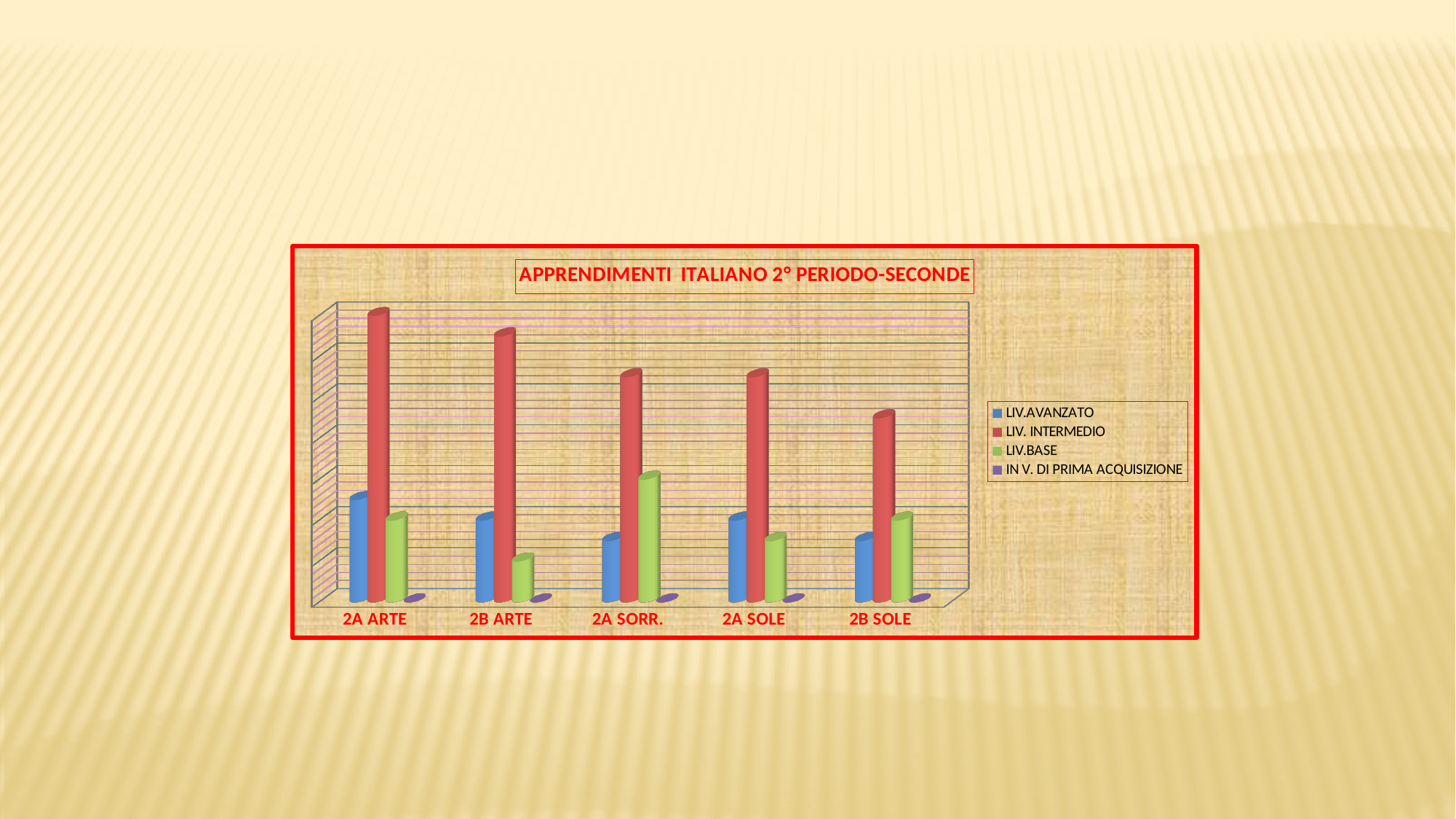
Which class has the highest LIV.BASE bar? 2A SORR. What kind of chart is shown on the slide? Bar chart Which class has the lowest LIV.BASE bar? 2B ARTE Which series is shown in red in the chart? LIV. INTERMEDIO What is the title of the chart? APPRENDIMENTI ITALIANO 2° PERIODO-SECONDE For 2A SORR., which is larger: LIV.AVANZATO or LIV.BASE? LIV.BASE How many classes (categories) are shown on the x axis of the chart? 5 Which class has the lowest LIV. INTERMEDIO bar? 2B SOLE How many series does the chart's legend list? 4 Which class has the highest LIV. INTERMEDIO bar? 2A ARTE Which class has the highest LIV.AVANZATO bar? 2A ARTE Which is larger: LIV. INTERMEDIO for 2A ARTE or LIV. INTERMEDIO for 2B ARTE? 2A ARTE